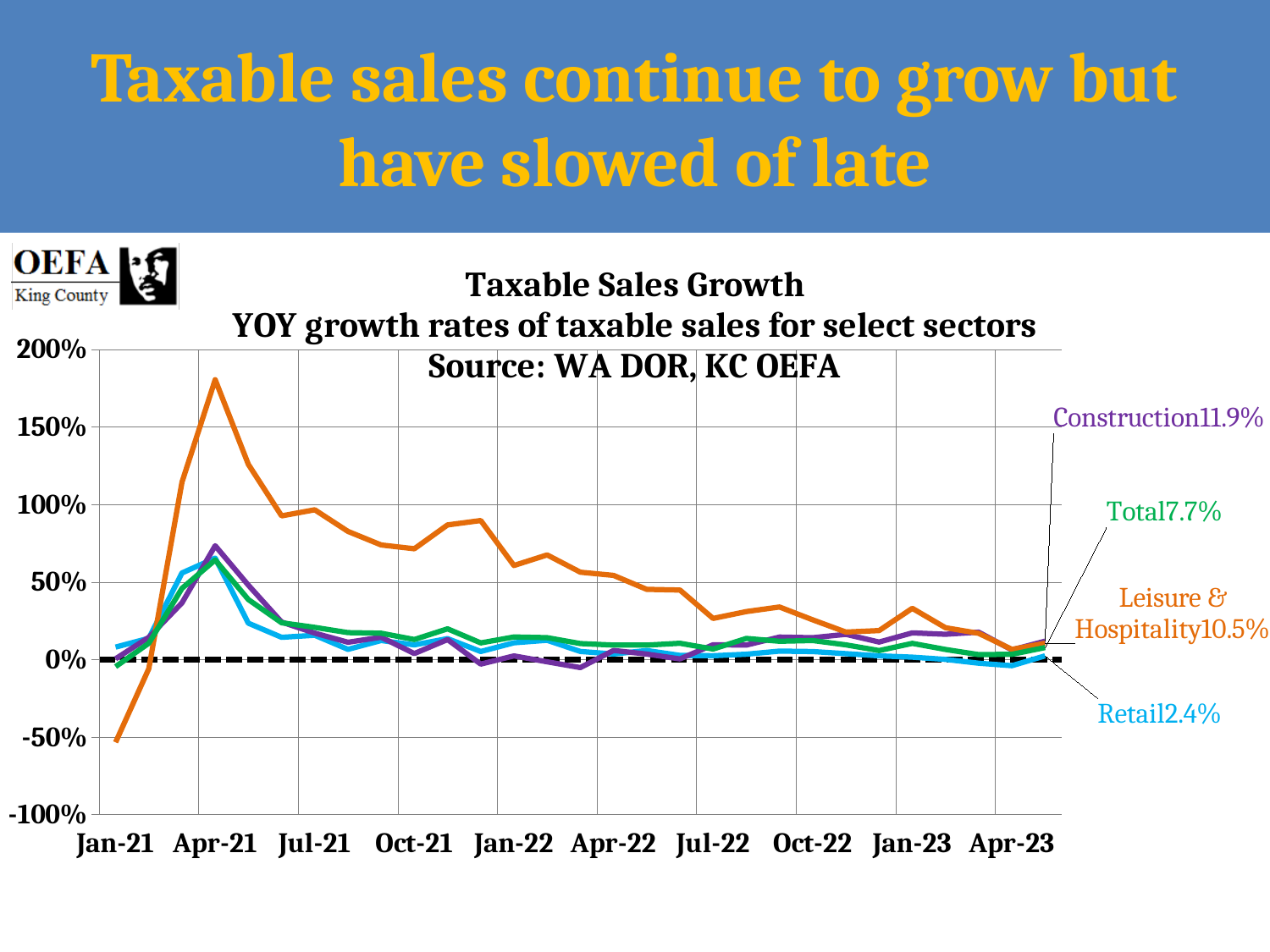
Which series has the highest labelled latest value? Construction What is the latest value labelled for Leisure & Hospitality? 10.5% Is the peak value of the Leisure & Hospitality line around Apr-21 greater or less than 150%? greater Does the Leisure & Hospitality line rise or fall from Apr-21 to Apr-23? Fall What is the latest value labelled for Retail? 2.4% How many series are plotted on the chart? 4 Which series has the lowest labelled latest value? Retail What is the latest value labelled for Total? 7.7% What is the latest value labelled for Construction? 11.9% Which is larger, the labelled latest value for Leisure & Hospitality or for Total? Leisure & Hospitality What kind of chart is shown? Line chart What is the difference between the labelled latest values for Construction and Retail? 9.5%